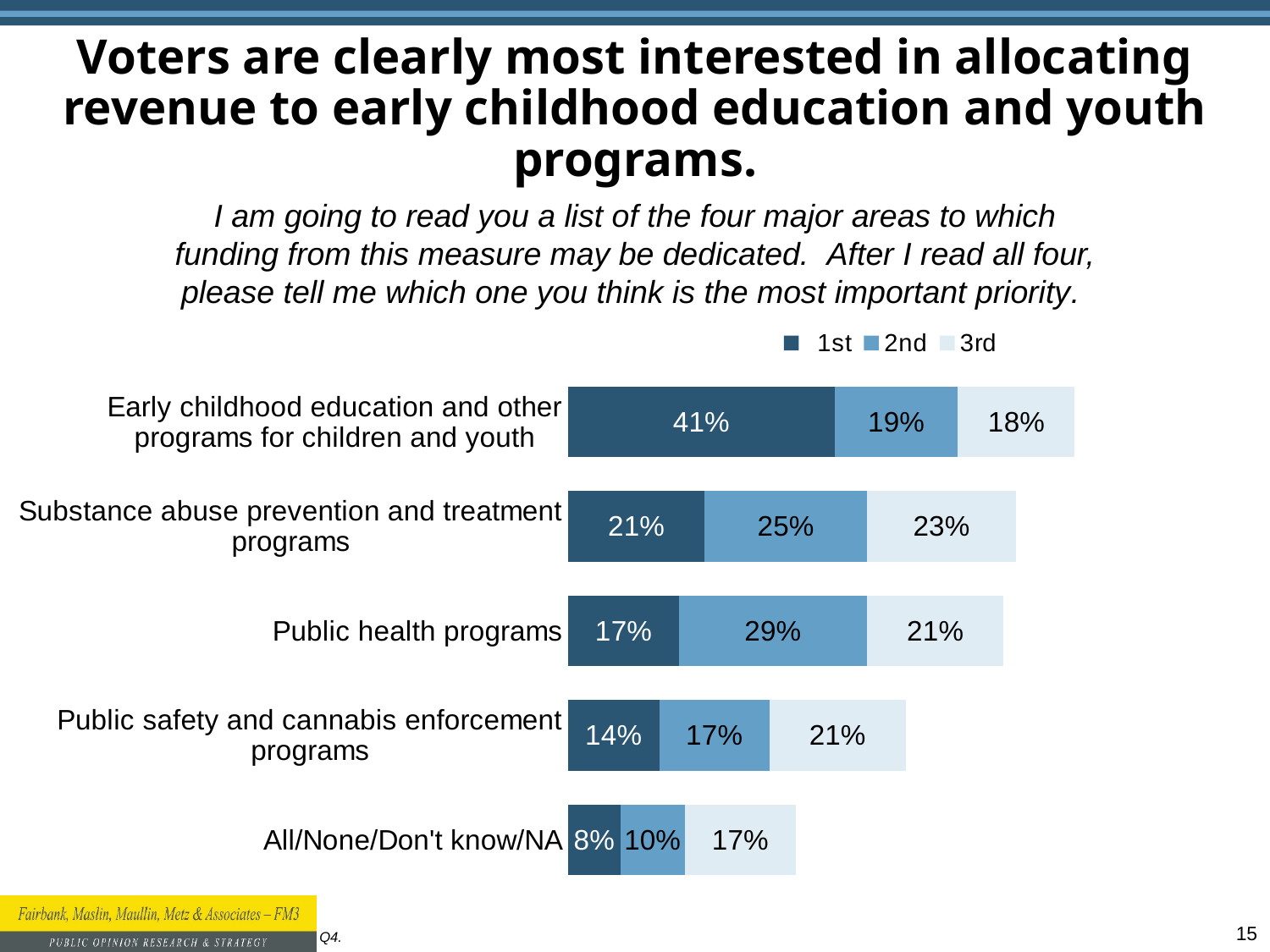
How many series does the legend list? 3 What is the 2nd-choice value for Public health programs? 29% What is the 3rd-choice value for Substance abuse prevention and treatment programs? 23% What is the difference between the 1st-choice percentages for Early childhood education and other programs for children and youth and Substance abuse prevention and treatment programs? 20% Which category has the highest 1st-choice percentage? Early childhood education and other programs for children and youth How many categories are shown in the chart? 5 What kind of chart is shown on the slide? Stacked bar chart Which is larger: the 2nd-choice value for Public health programs or the 2nd-choice value for Substance abuse prevention and treatment programs? Public health programs What is the 1st-choice value for All/None/Don't know/NA? 8% Which category has the lowest 1st-choice percentage? All/None/Don't know/NA What percentage of voters ranked Early childhood education and other programs for children and youth as their 1st priority? 41% What is the total of the stacked bar for Public safety and cannabis enforcement programs? 52%